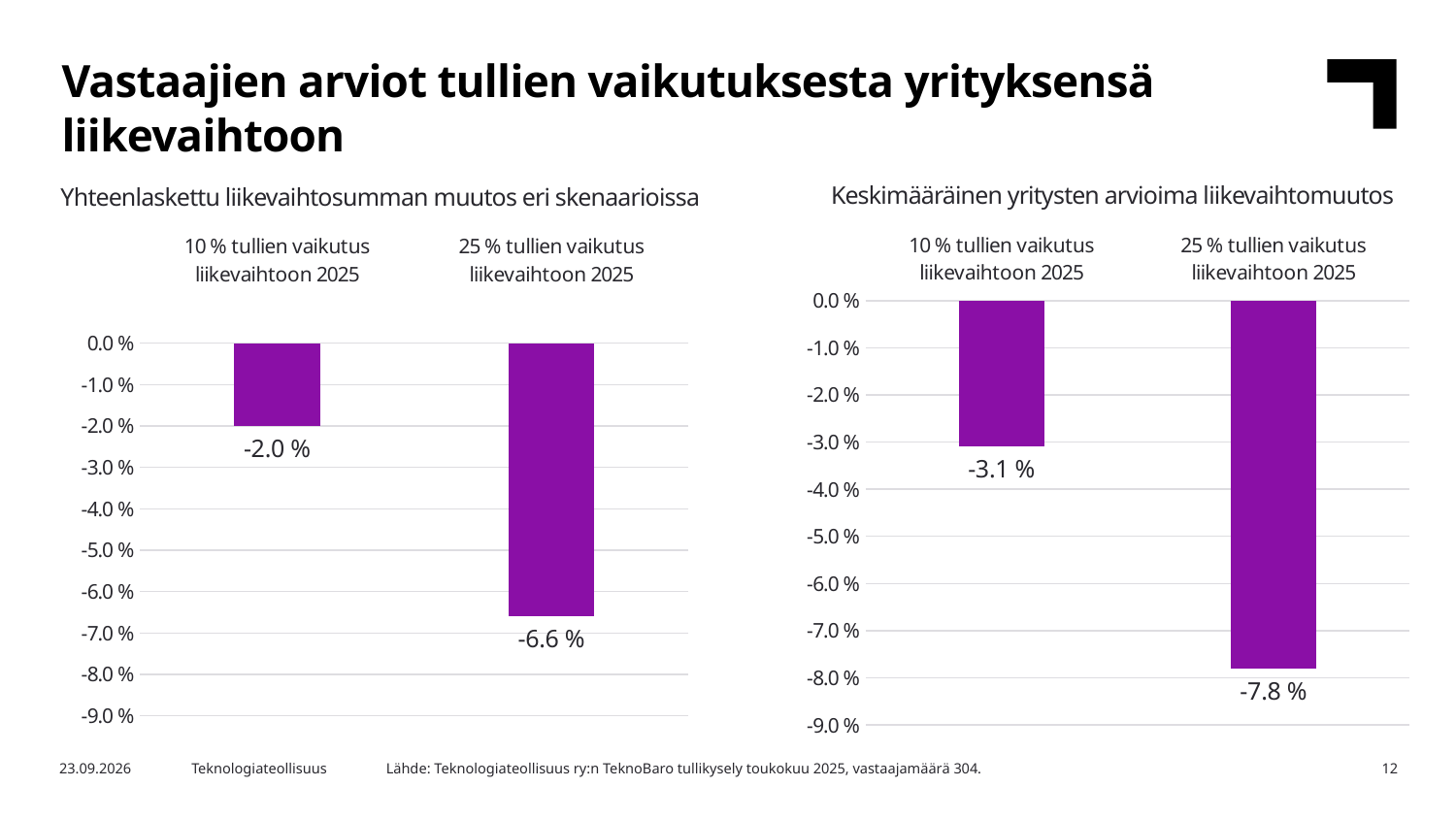
In the left chart (Yhteenlaskettu liikevaihtosumman muutos eri skenaarioissa), what is the value for '10 % tullien vaikutus liikevaihtoon 2025'? -2.0 % In the right chart (Keskimääräinen yritysten arvioima liikevaihtomuutos), what is the value for '25 % tullien vaikutus liikevaihtoon 2025'? -7.8 % In the left chart, what is the difference between the values for the 10 % and 25 % tariff scenarios? 4.6 percentage points What is the title of the right chart? Keskimääräinen yritysten arvioima liikevaihtomuutos In the right chart, what is the difference between the values for the 10 % and 25 % tariff scenarios? 4.7 percentage points In the right chart, which scenario has the highest (least negative) value? 10 % tullien vaikutus liikevaihtoon 2025 Which is larger: the value for '25 % tullien vaikutus liikevaihtoon 2025' in the left chart or in the right chart? Left chart (-6.6 %) What type of chart is the left chart? Bar chart How many categories are shown in the right chart? 2 In the left chart (Yhteenlaskettu liikevaihtosumman muutos eri skenaarioissa), what is the value for '25 % tullien vaikutus liikevaihtoon 2025'? -6.6 % In the left chart, which scenario has the lowest (most negative) value? 25 % tullien vaikutus liikevaihtoon 2025 In the right chart (Keskimääräinen yritysten arvioima liikevaihtomuutos), what is the value for '10 % tullien vaikutus liikevaihtoon 2025'? -3.1 %